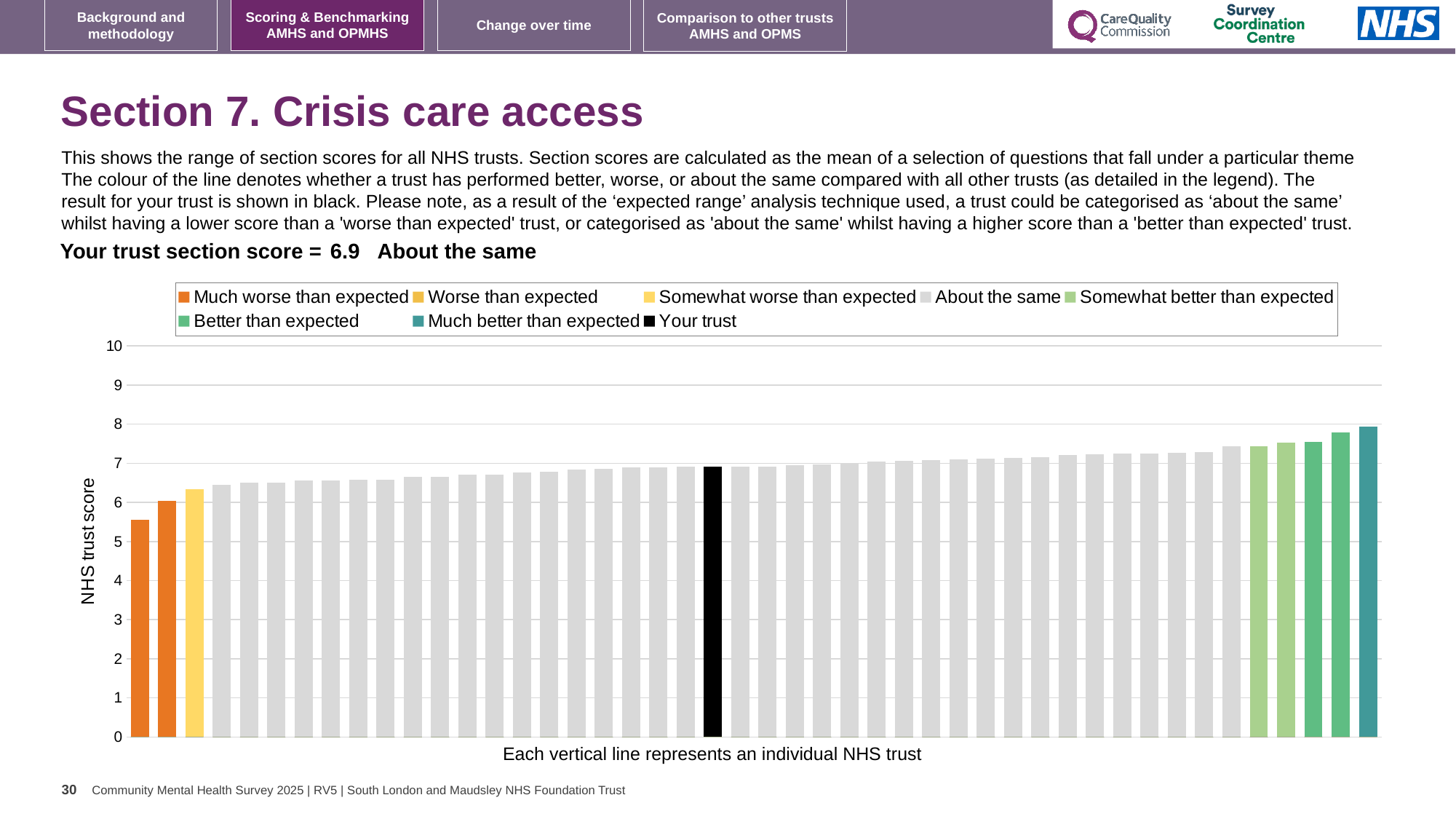
How many bars are coloured as 'Much better than expected'? 1 Is the value of the lowest bar in the chart greater or less than 6? less How many bars are coloured as 'Much worse than expected'? 2 What is the section score for your trust shown on the slide? 6.9 Which legend category does the tallest bar in the chart belong to? Much better than expected Which benchmarking category is your trust placed in for Section 7? About the same What is the label on the vertical axis of the chart? NHS trust score Is the value of the black 'Your trust' bar greater or less than 6? greater What kind of chart is shown on the slide? Bar chart How many entries does the chart legend list? 8 Do the bar values rise or fall moving from left to right along the x axis? Rise